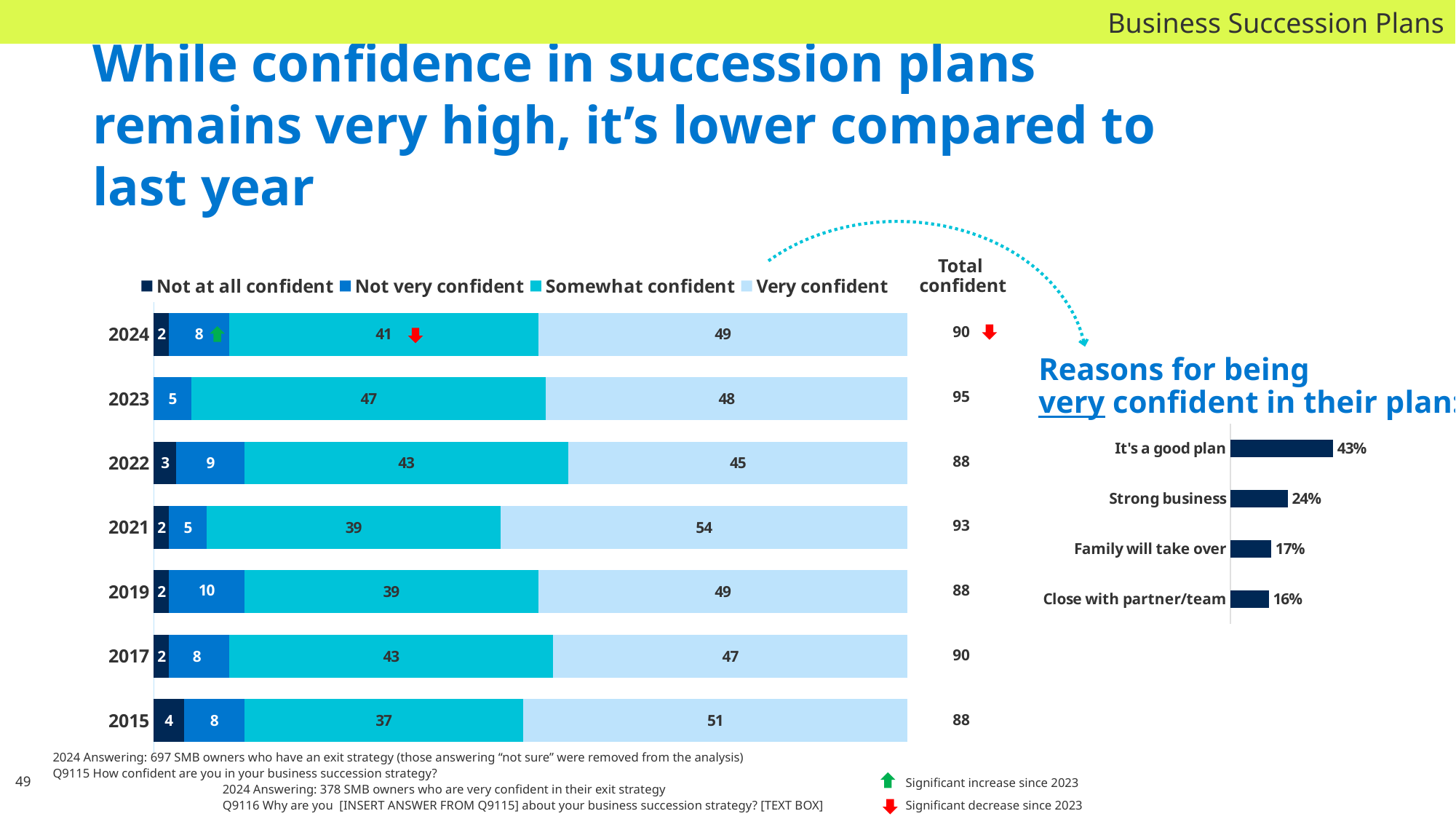
In the stacked bar chart of confidence by year, what is the value for "Somewhat confident" in 2024? 41 How many years are shown in the stacked bar chart of confidence by year? 7 In the stacked bar chart of confidence by year, what is the value for "Very confident" in 2021? 54 In the stacked bar chart of confidence by year, which year has the highest "Very confident" value? 2021 What is the "Total confident" value shown for 2023? 95 In the stacked bar chart of confidence by year, which year has the lowest "Somewhat confident" value? 2015 In the "Reasons for being very confident in their plans" chart, which reason has the highest value? It's a good plan In the stacked bar chart of confidence by year, what is the "Not very confident" value for 2019? 10 In the stacked bar chart of confidence by year, what is the difference between the "Somewhat confident" values for 2023 and 2024? 6 In the "Reasons for being very confident in their plans" chart, what is the value for "Strong business"? 24% How many series does the legend of the stacked bar chart of confidence by year list? 4 In the stacked bar chart of confidence by year, is the "Very confident" value larger in 2022 or in 2015? 2015